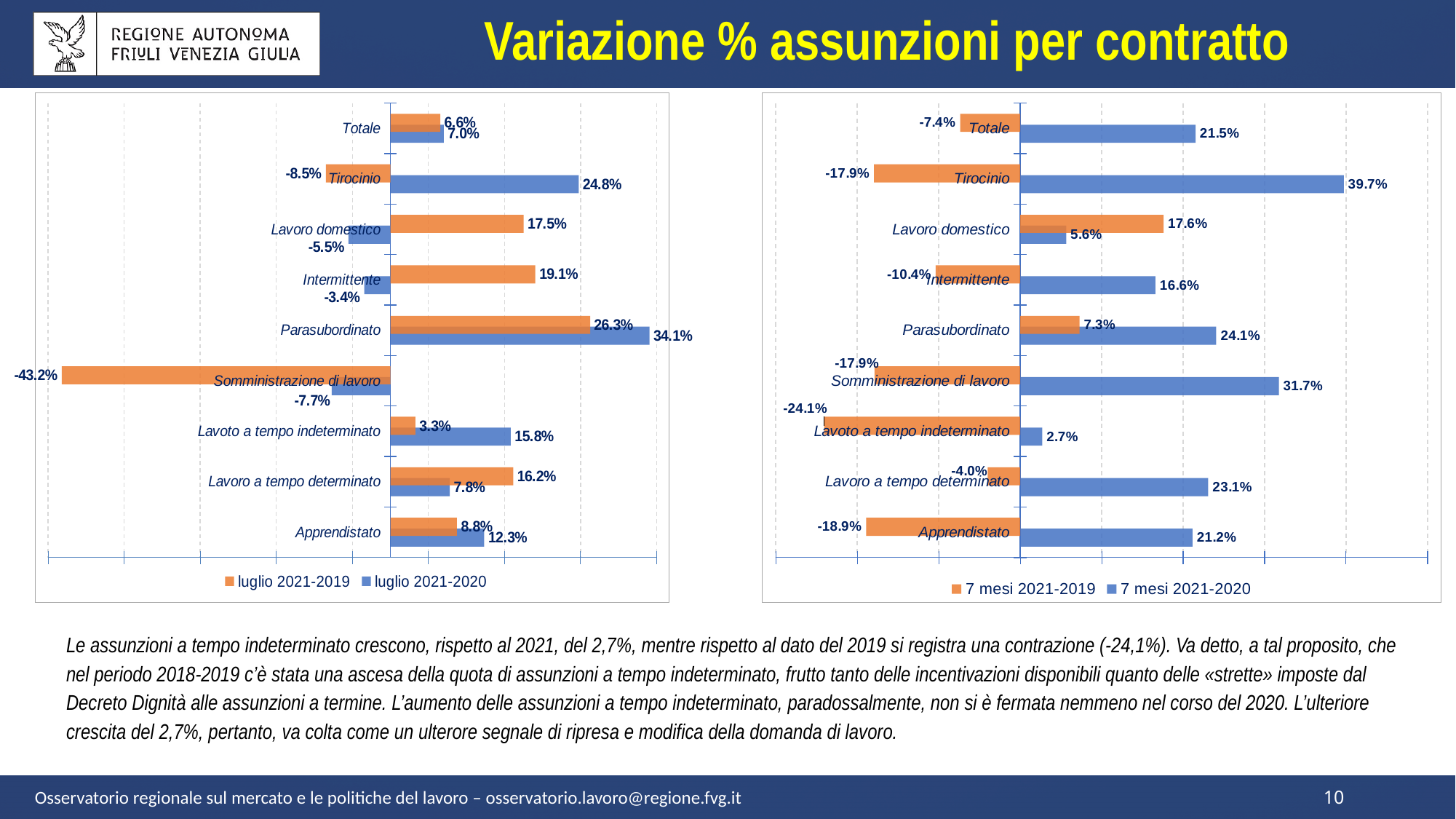
In the right chart, what is the value for Tirocinio in the 7 mesi 2021-2020 series? 39.7% What are the two series listed in the legend of the right chart? 7 mesi 2021-2019 and 7 mesi 2021-2020 In the right chart, what is the difference between the 7 mesi 2021-2020 and 7 mesi 2021-2019 values for Totale? 28.9 percentage points In the left chart, what is the value for Somministrazione di lavoro in the luglio 2021-2019 series? -43.2% In the left chart, which is larger for Lavoro a tempo determinato: the luglio 2021-2019 value or the luglio 2021-2020 value? luglio 2021-2019 How many categories are shown in the right chart? 9 How many series does the legend of the left chart list? 2 What type of chart is the left chart? Bar chart In the left chart, what is the value for Parasubordinato in the luglio 2021-2020 series? 34.1% In the right chart, what is the value for Lavoto a tempo indeterminato in the 7 mesi 2021-2019 series? -24.1% In the left chart, which category has the highest value in the luglio 2021-2019 series? Parasubordinato In the right chart, which category has the lowest value in the 7 mesi 2021-2019 series? Lavoto a tempo indeterminato